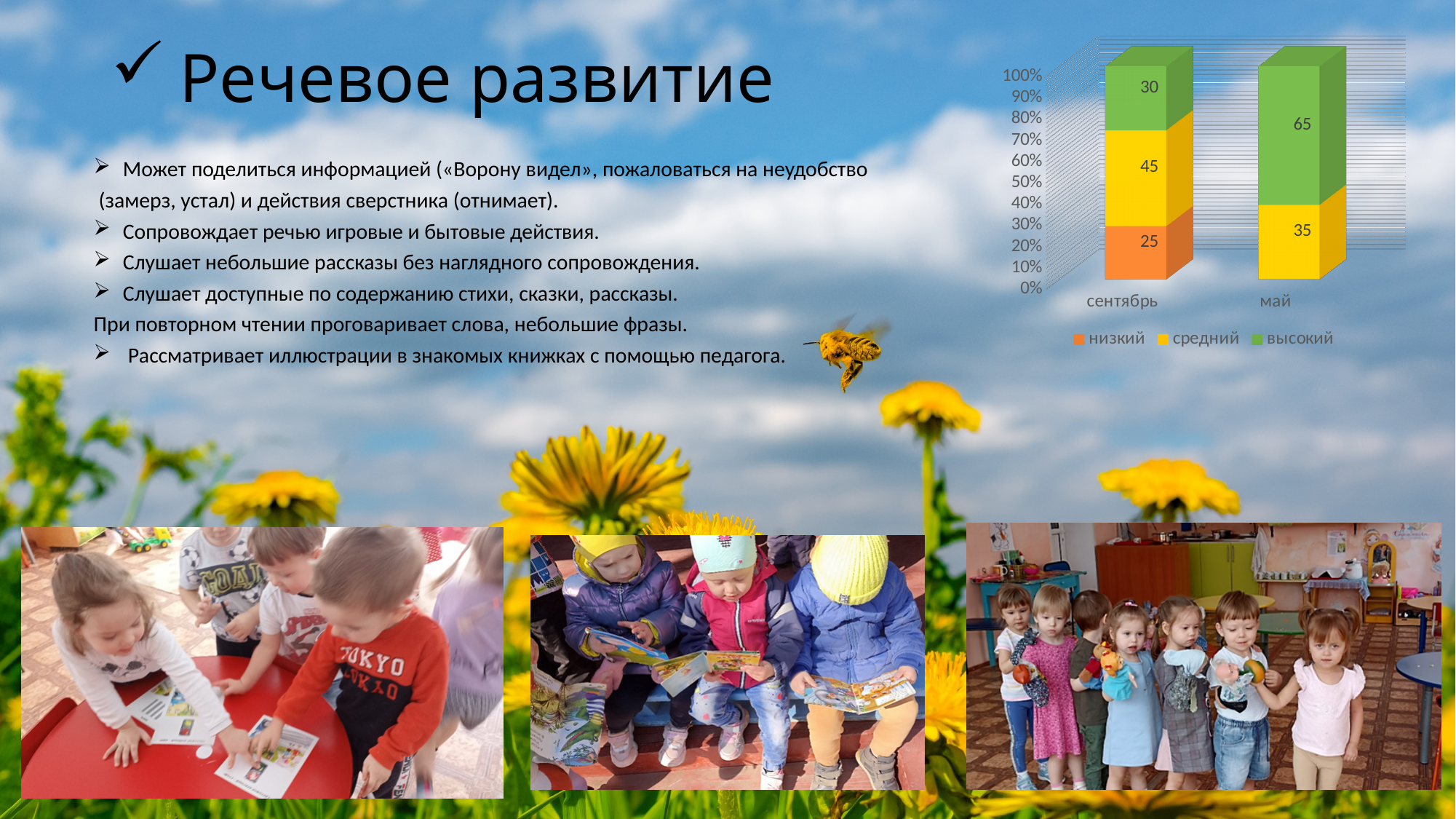
What is the total of the stacked bar for сентябрь? 100 How many categories are shown on the x axis of the chart? 2 By how much does the высокий value for май exceed the высокий value for сентябрь? 35 Which category has the larger высокий value, сентябрь or май? май What is the value of the средний series for сентябрь? 45 What kind of chart is shown on the slide? stacked bar chart What is the value of the высокий series for май? 65 What is the value of the высокий series for сентябрь? 30 What is the difference between the средний values for сентябрь and май? 10 What is the value of the средний series for май? 35 What is the value of the низкий series for сентябрь? 25 How many series does the chart legend list? 3